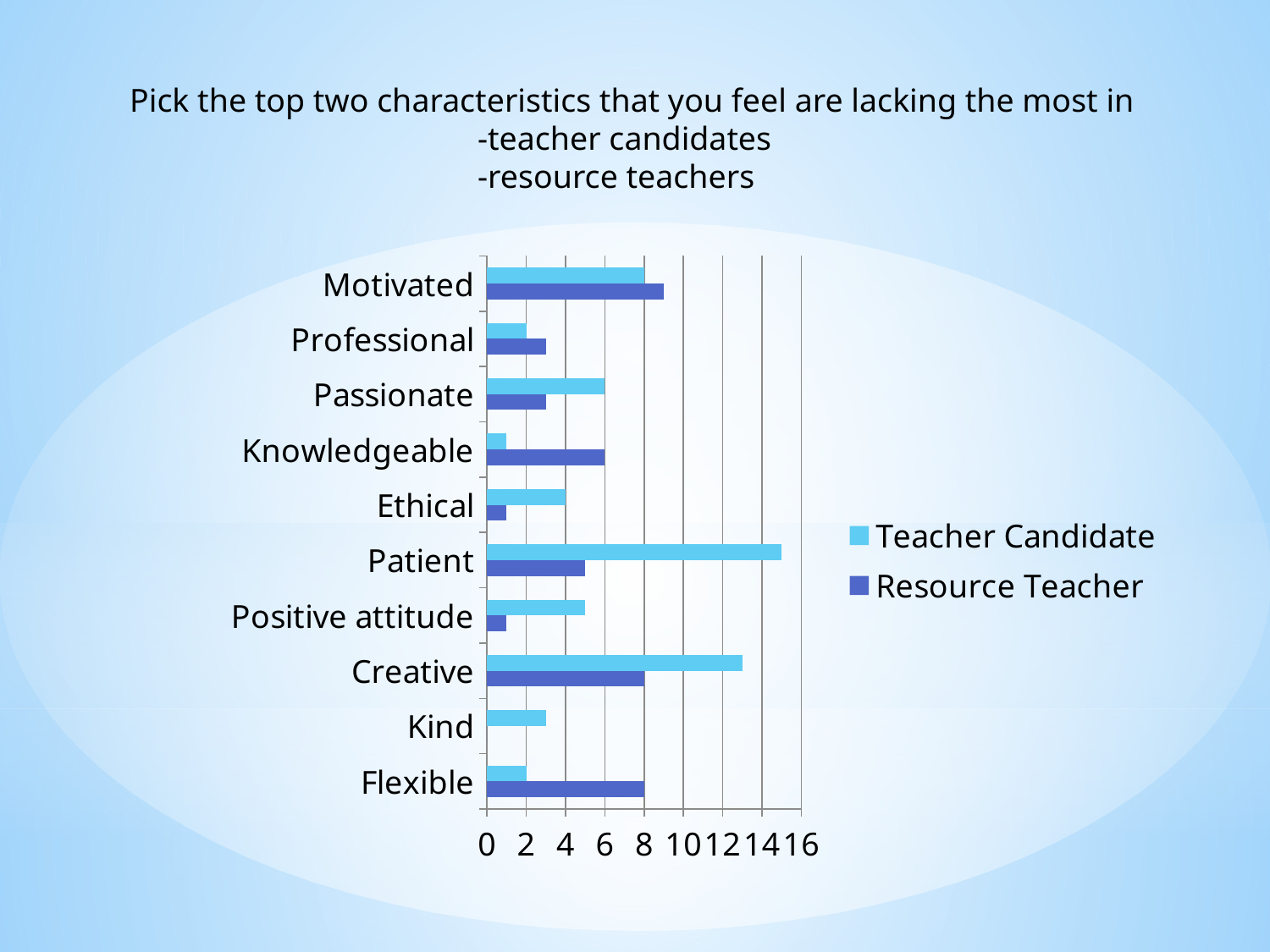
What is the Teacher Candidate value for Motivated? 8 What kind of chart is shown on the slide? bar chart Which characteristic has the lowest Resource Teacher value? Kind Which characteristic has the highest Teacher Candidate value? Patient How many series does the chart's legend list? 2 What is the Teacher Candidate value for Ethical? 4 How many characteristics are listed on the vertical axis of the chart? 10 Is the Teacher Candidate value for Creative greater or less than 12? greater What is the difference between the Resource Teacher and Teacher Candidate values for Flexible? 6 What are the two series named in the chart's legend? Teacher Candidate and Resource Teacher For Patient, which series has the larger value, Teacher Candidate or Resource Teacher? Teacher Candidate What is the Resource Teacher value for Flexible? 8